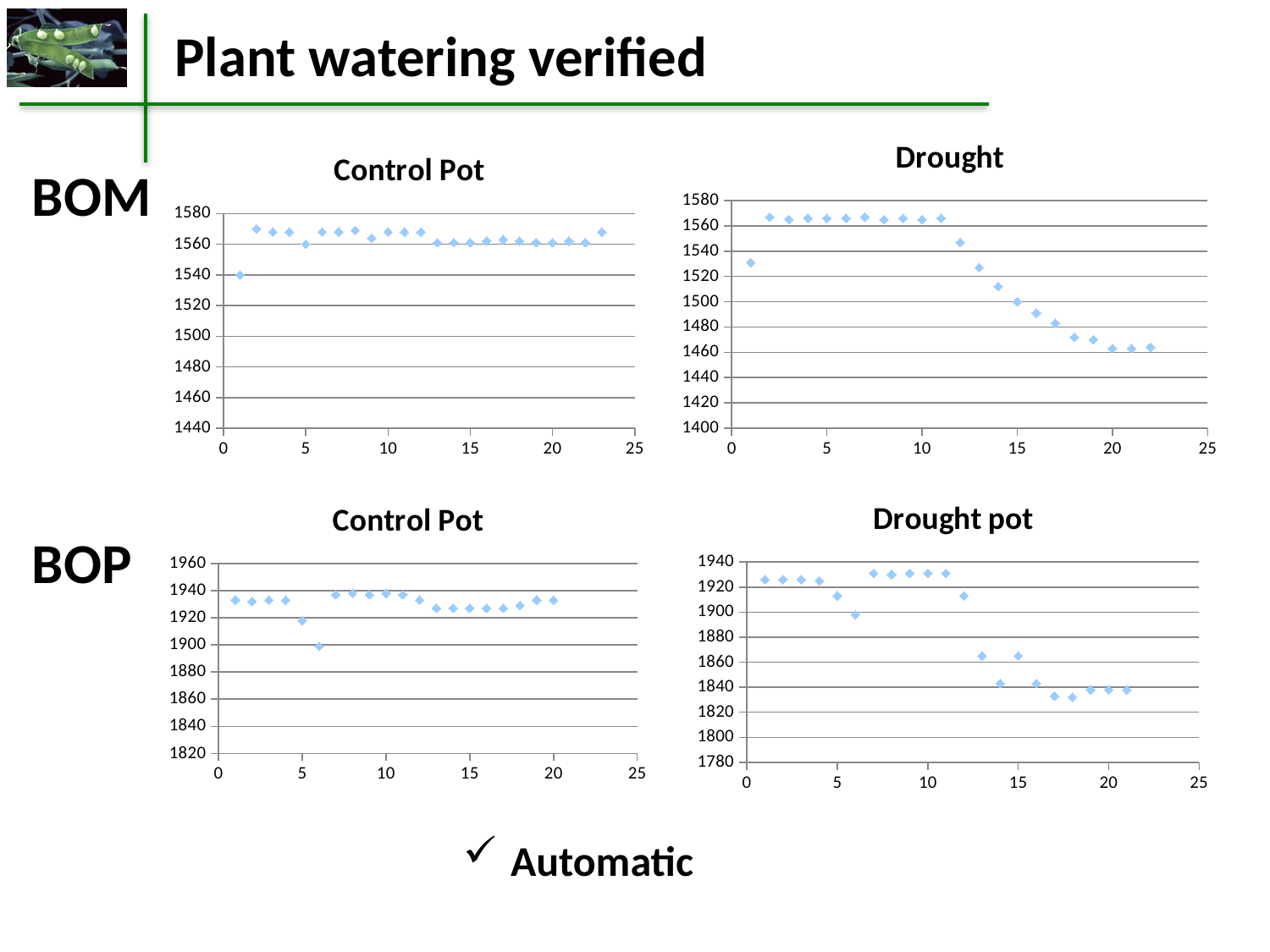
How many data points are plotted in the bottom-left 'Control Pot' chart? 20 In the top-left 'Control Pot' chart, at which x value is the lowest point? 1 In the bottom-right 'Drought pot' chart, do the values generally rise or fall as x increases? fall In the top-right 'Drought' chart, which is larger, the value at x = 5 or the value at x = 20? x = 5 What kind of chart is the top-left 'Control Pot' chart? scatter chart What is the title of the bottom-right chart? Drought pot In the top-right 'Drought' chart, is the value at x = 20 greater or less than 1480? less In the bottom-left 'Control Pot' chart, is the value at x = 6 greater or less than 1920? less In the bottom-left 'Control Pot' chart, at which x value is the lowest point? 6 In the top-left 'Control Pot' chart, is the value at x = 1 greater or less than 1560? less In the top-right 'Drought' chart, do the values generally rise or fall as x increases? fall